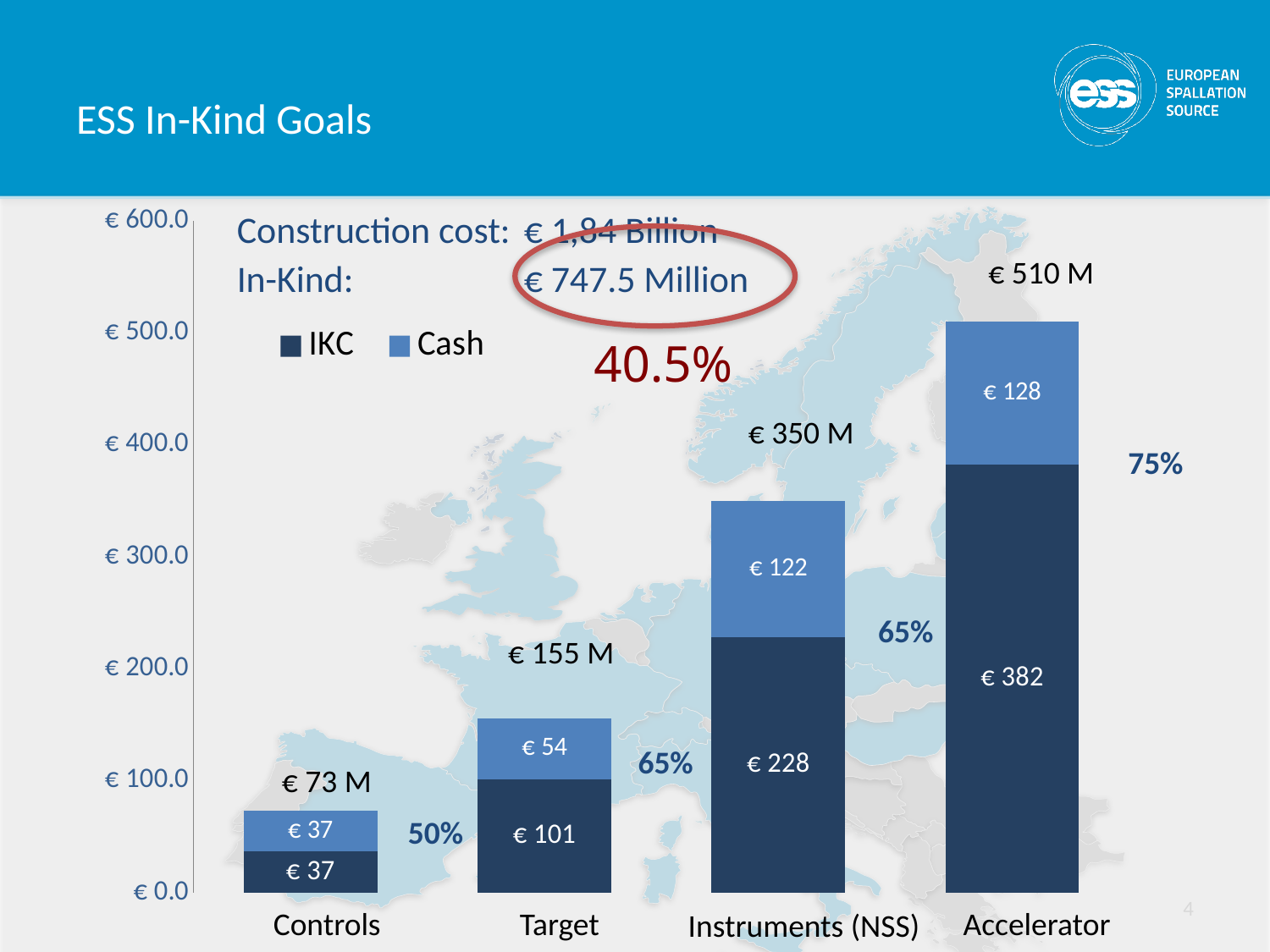
How many series does the chart legend list? 2 Which is larger, the Cash value for Target or the Cash value for Instruments (NSS)? Instruments (NSS) What type of chart is shown on the slide? stacked bar chart Which category has the highest total bar? Accelerator What total is labelled above the Controls bar? € 73 M What is the Cash value for Instruments (NSS)? € 122 How many categories are shown on the x axis of the chart? 4 What is the difference between the IKC values for Accelerator and Instruments (NSS)? € 154 Which category has the lowest total bar? Controls What is the IKC value for Accelerator? € 382 What total is labelled above the Accelerator bar? € 510 M What is the IKC value for Target? € 101